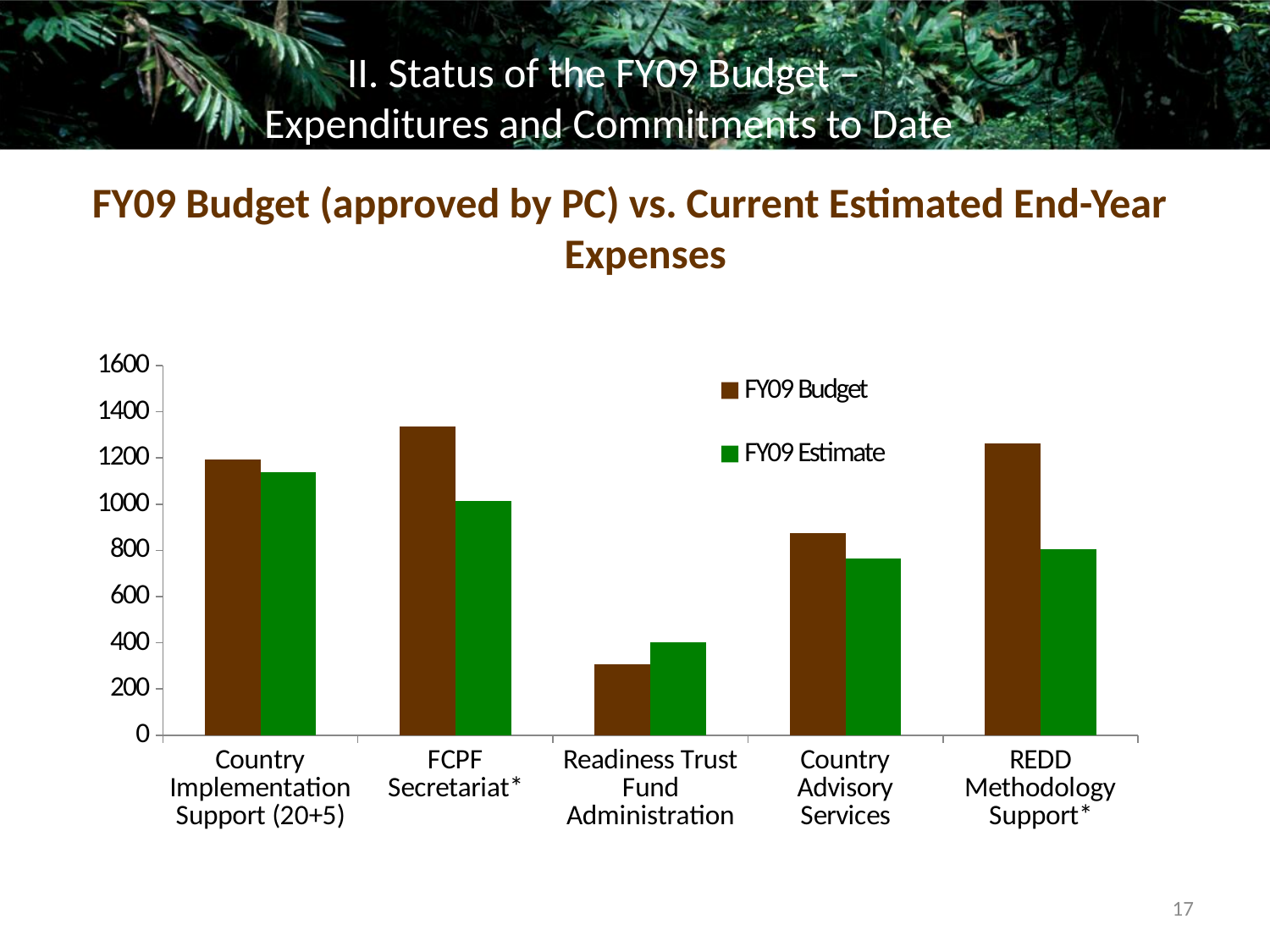
Is the FY09 Estimate value for REDD Methodology Support* greater or less than 1000? less How many categories are shown on the x axis? 5 Which category has the lowest FY09 Budget value? Readiness Trust Fund Administration Which category has the lowest FY09 Estimate value? Readiness Trust Fund Administration How many series does the legend list? 2 Is the FY09 Budget value for FCPF Secretariat* greater or less than 1200? greater Which category has the highest FY09 Estimate value? Country Implementation Support (20+5) Which colour represents the FY09 Estimate series in the legend? green Is the FY09 Estimate value for Readiness Trust Fund Administration greater or less than 600? less Which category has the highest FY09 Budget value? FCPF Secretariat* What kind of chart is shown on the slide? bar chart For Readiness Trust Fund Administration, which is larger: the FY09 Budget or the FY09 Estimate? FY09 Estimate